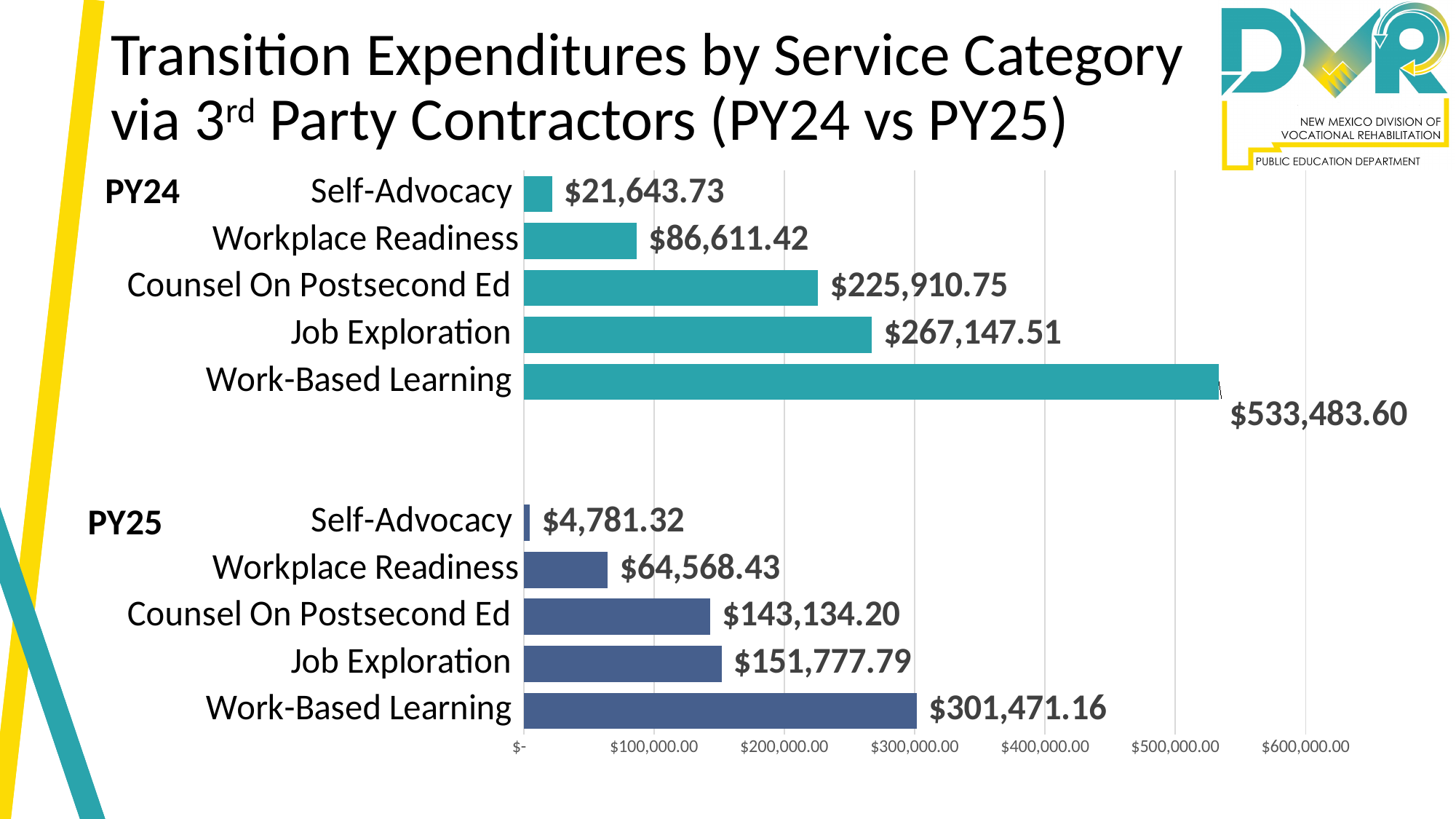
What was the PY24 expenditure for Counsel On Postsecond Ed? $225,910.75 What is the difference between the PY24 Job Exploration and PY24 Counsel On Postsecond Ed expenditures? $41,236.76 How many service categories are shown for each program year? 5 Which service category had the lowest PY24 expenditure? Self-Advocacy What was the PY24 expenditure for Work-Based Learning? $533,483.60 Which service category had the highest PY25 expenditure? Work-Based Learning Which was larger: the PY24 Workplace Readiness expenditure or the PY25 Job Exploration expenditure? PY25 Job Exploration How much higher was the Work-Based Learning expenditure in PY24 than in PY25? $232,012.44 What kind of chart is shown on the slide? Bar chart What was the PY25 expenditure for Workplace Readiness? $64,568.43 Is the PY25 Work-Based Learning expenditure greater or less than $400,000.00? less What was the PY25 expenditure for Self-Advocacy? $4,781.32